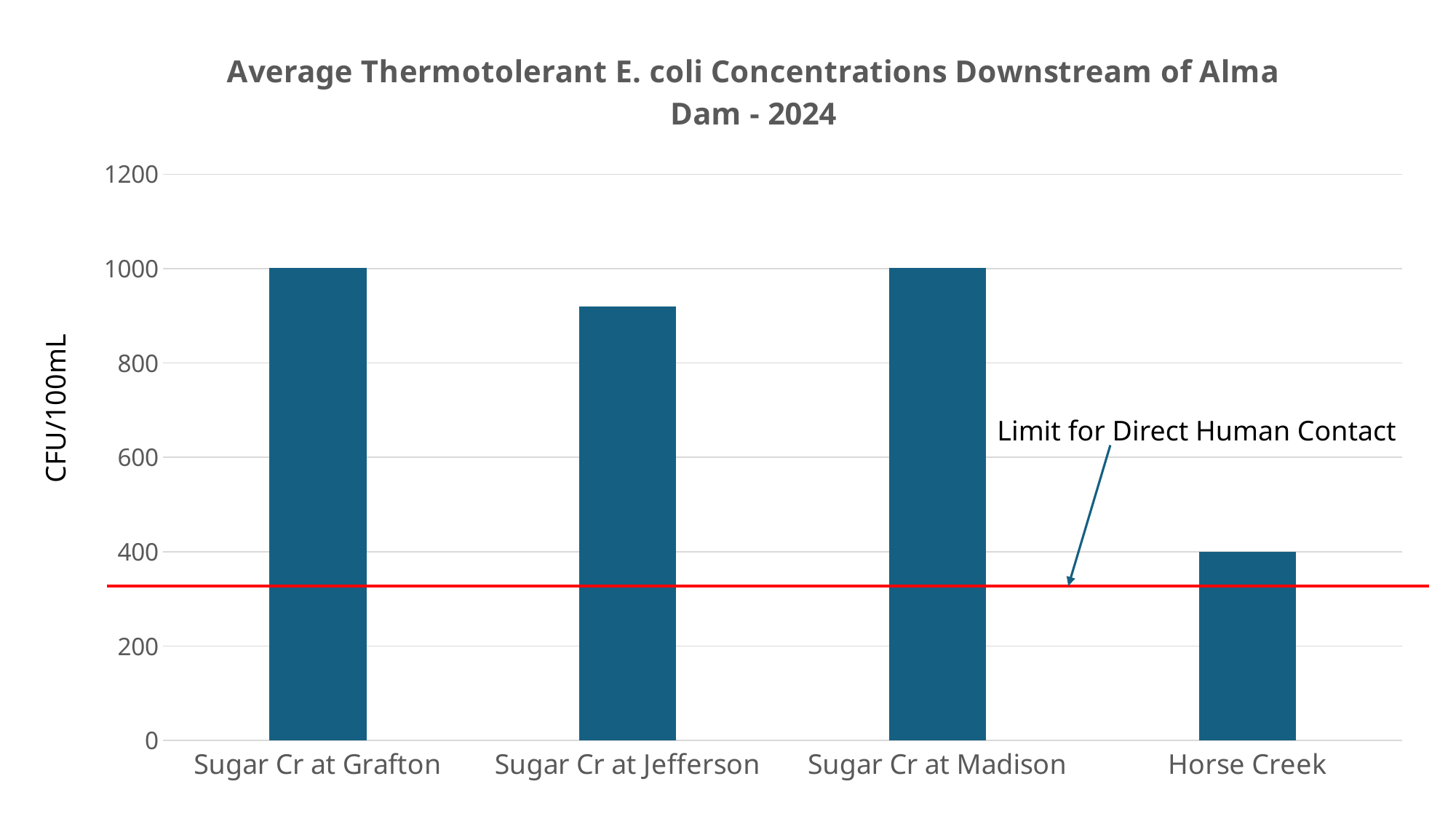
What is the value for Horse Creek? 400 Which category has the lowest value? Horse Creek What kind of chart is this? bar chart Which is larger, the value for Sugar Cr at Jefferson or the value for Horse Creek? Sugar Cr at Jefferson Is the value for Sugar Cr at Jefferson greater or less than 1000? less Which is larger, the value for Sugar Cr at Grafton or the value for Sugar Cr at Jefferson? Sugar Cr at Grafton How many categories are shown on the x axis? 4 Is the value for Sugar Cr at Jefferson greater or less than 800? greater What does the red horizontal line represent? Limit for Direct Human Contact